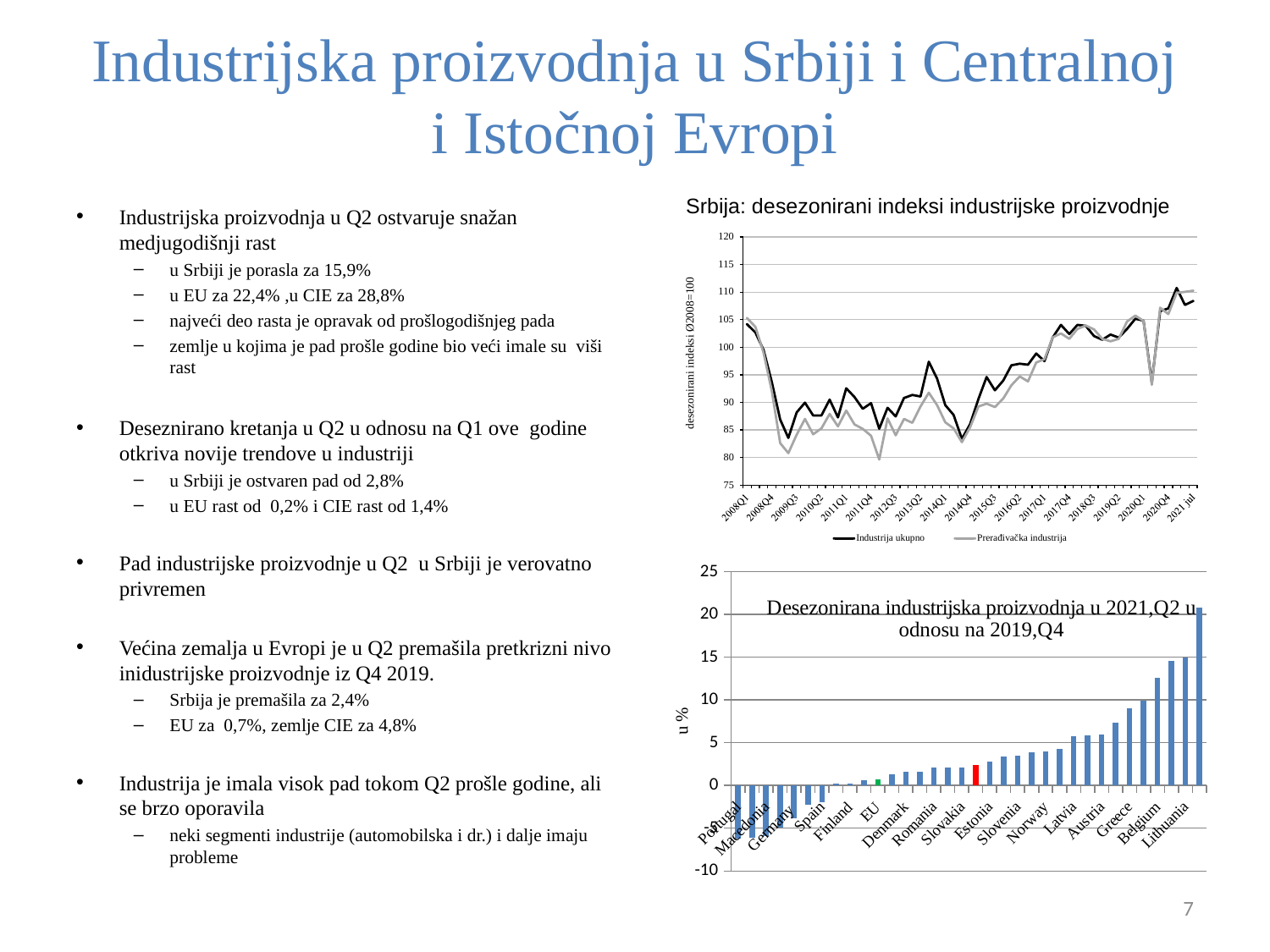
In the chart 'Desezonirana industrijska proizvodnja u 2021,Q2 u odnosu na 2019,Q4', do the values rise or fall from left to right along the x axis? rise What kind of chart is the chart titled 'Srbija: desezonirani indeksi industrijske proizvodnje'? line chart In the chart 'Srbija: desezonirani indeksi industrijske proizvodnje', is the value for Industrija ukupno at 2008Q1 greater or less than 100? greater In the chart 'Srbija: desezonirani indeksi industrijske proizvodnje', is the value for Industrija ukupno at 2021 jul greater or less than 105? greater In the chart 'Desezonirana industrijska proizvodnja u 2021,Q2 u odnosu na 2019,Q4', which is larger, the value for Germany or the value for Latvia? Latvia What kind of chart is the chart titled 'Desezonirana industrijska proizvodnja u 2021,Q2 u odnosu na 2019,Q4'? bar chart In the chart 'Desezonirana industrijska proizvodnja u 2021,Q2 u odnosu na 2019,Q4', which country has the lowest value? Portugal In the chart 'Srbija: desezonirani indeksi industrijske proizvodnje', what are the two series named in the legend? Industrija ukupno and Prerađivačka industrija How many series does the legend of the chart 'Srbija: desezonirani indeksi industrijske proizvodnje' list? 2